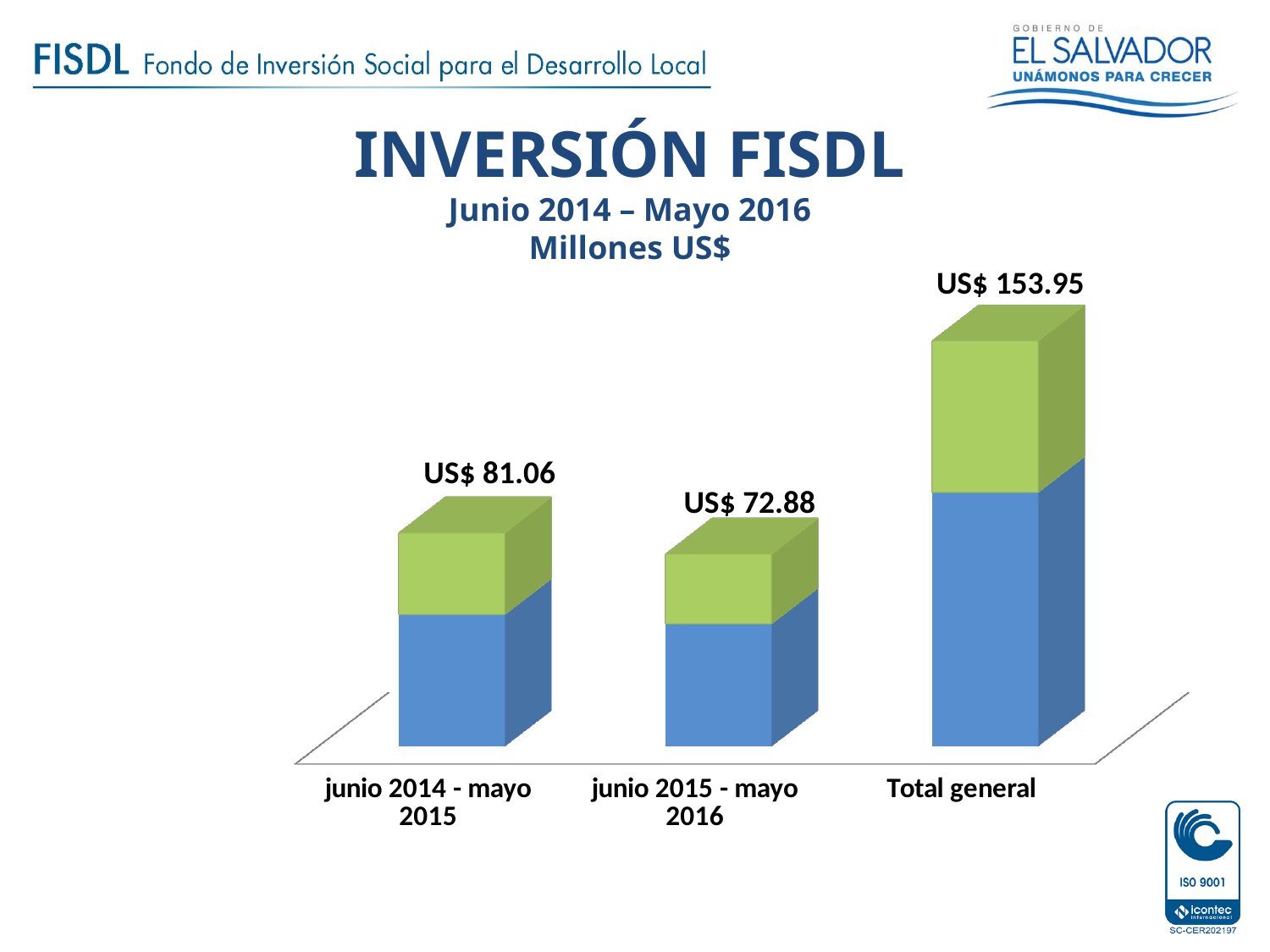
Which is larger, the value for junio 2014 - mayo 2015 or the value for junio 2015 - mayo 2016? junio 2014 - mayo 2015 Which category has the highest value? Total general What is the value for junio 2015 - mayo 2016? US$ 72.88 In what units are the chart values expressed, according to the subtitle? Millones US$ How many bars are shown in the chart? 3 What is the value for Total general? US$ 153.95 What is the difference between the values for junio 2014 - mayo 2015 and junio 2015 - mayo 2016? US$ 8.18 What kind of chart is shown on the slide? Bar chart What is the value for junio 2014 - mayo 2015? US$ 81.06 Which category has the lowest value? junio 2015 - mayo 2016 What is the difference between the values for Total general and junio 2014 - mayo 2015? US$ 72.88 Did the investment rise or fall from junio 2014 - mayo 2015 to junio 2015 - mayo 2016? Fall